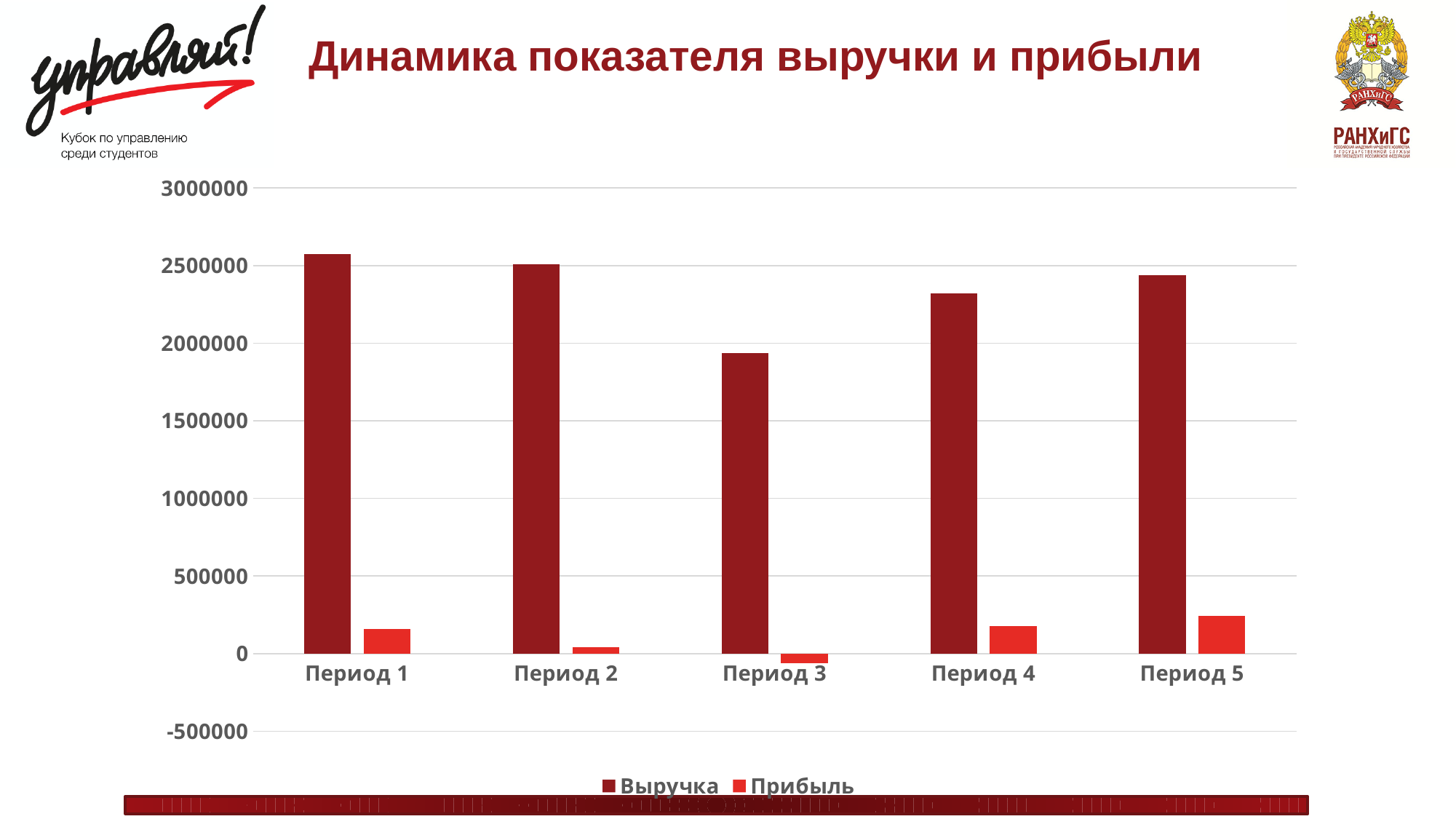
Which is larger: Выручка for Период 3 or Выручка for Период 4? Период 4 What is the title of the chart on the slide? Динамика показателя выручки и прибыли Is the value of Выручка for Период 3 greater or less than 2000000? less Is the value of Прибыль for Период 3 greater or less than 0? less Is the value of Выручка for Период 1 greater or less than 2500000? greater What kind of chart is shown on the slide? bar chart Which period has the lowest value for Выручка? Период 3 How many periods (categories) are shown on the x axis? 5 How many series does the legend list? 2 Which period has the highest value for Прибыль? Период 5 Which period has the lowest value for Прибыль? Период 3 Which is larger: Прибыль for Период 1 or Прибыль for Период 2? Период 1